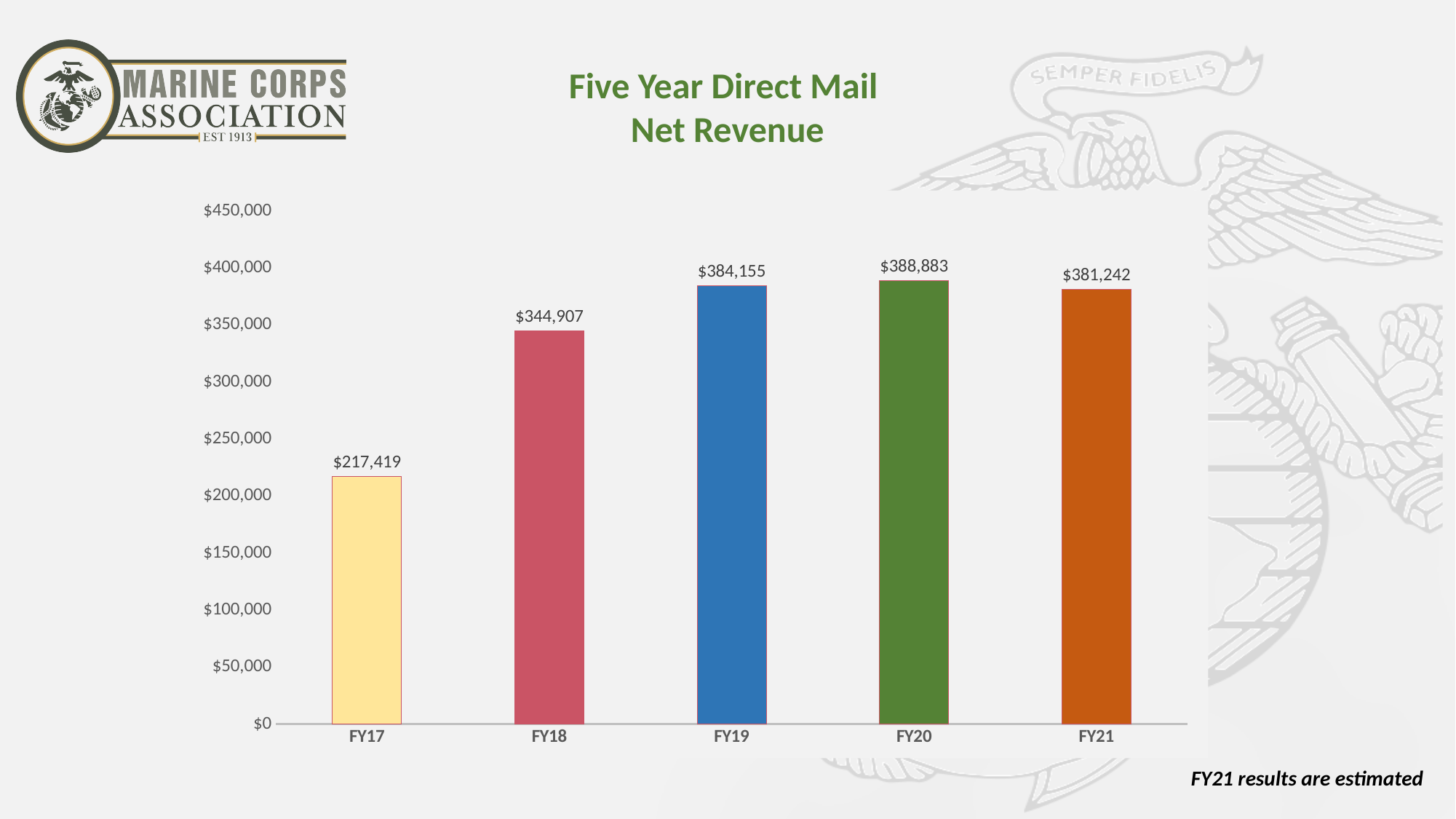
What is the net revenue for FY21? $381,242 Which fiscal year has the lowest net revenue? FY17 What is the title of the chart? Five Year Direct Mail Net Revenue Which has the larger net revenue, FY19 or FY21? FY19 How many fiscal years are shown on the chart? 5 What kind of chart is shown on the slide? bar chart What is the net revenue for FY20? $388,883 What is the net revenue for FY17? $217,419 Is the value for FY17 greater or less than $250,000? less What is the difference in net revenue between FY18 and FY17? $127,488 What is the difference in net revenue between FY20 and FY21? $7,641 Which fiscal year has the highest net revenue? FY20